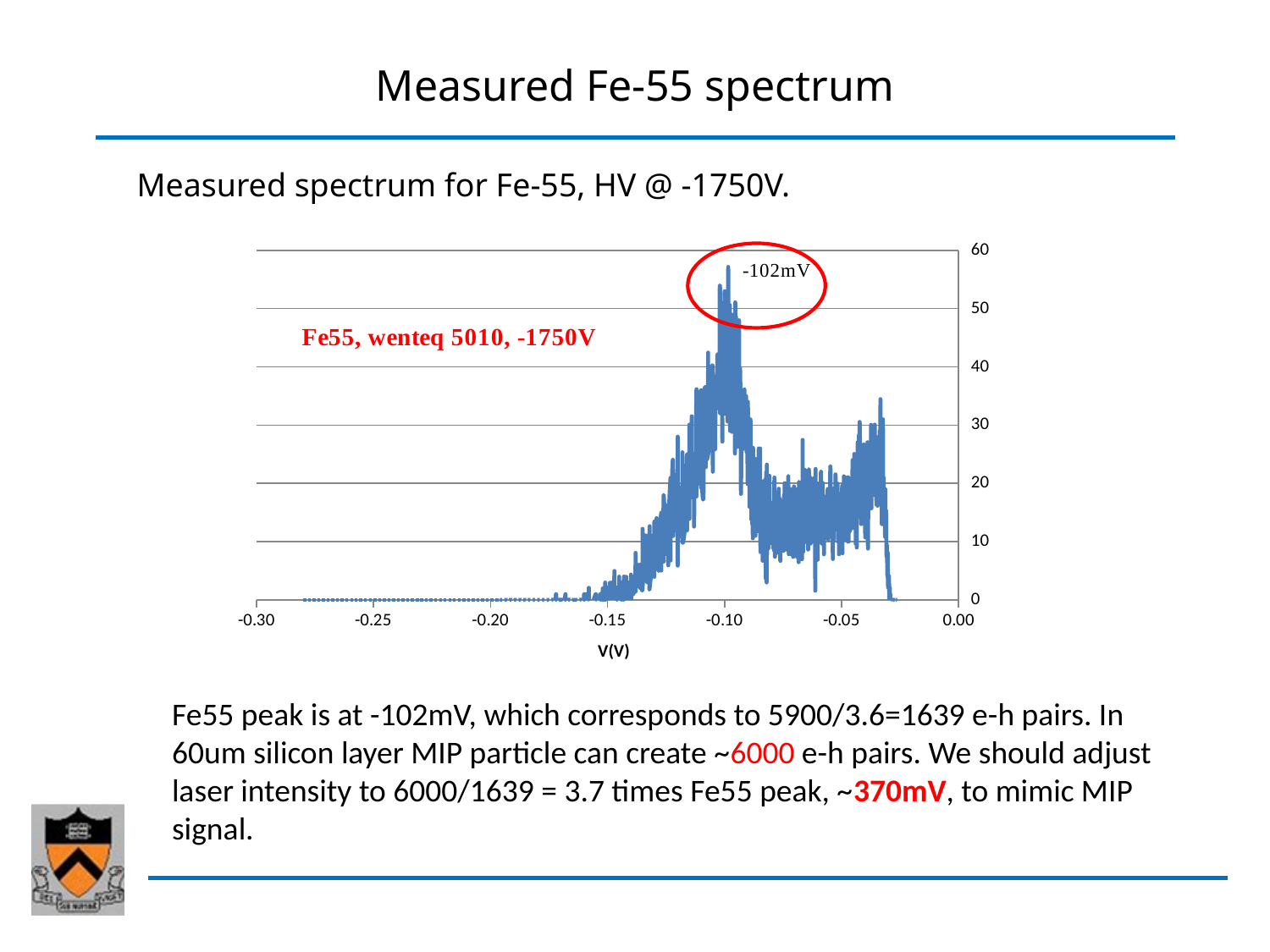
Do the values rise or fall along the x axis between -0.10 V and -0.08 V? fall Is the value of the spectrum at -0.20 V greater or less than 10? less What kind of chart is shown on the slide? Line chart Do the values rise or fall along the x axis between -0.15 V and -0.10 V? rise What is the label of the x axis of the chart? V(V) Is the height of the main peak of the spectrum greater or less than 50? greater Is the value of the secondary peak near -0.035 V greater or less than 20? greater What is the highest tick value shown on the y axis? 60 What is the lowest tick value shown on the x axis? -0.30 At what voltage does the annotation on the chart place the main peak? -102mV What is the title printed inside the chart area? Fe55, wenteq 5010, -1750V How many data series are plotted in the chart? 1